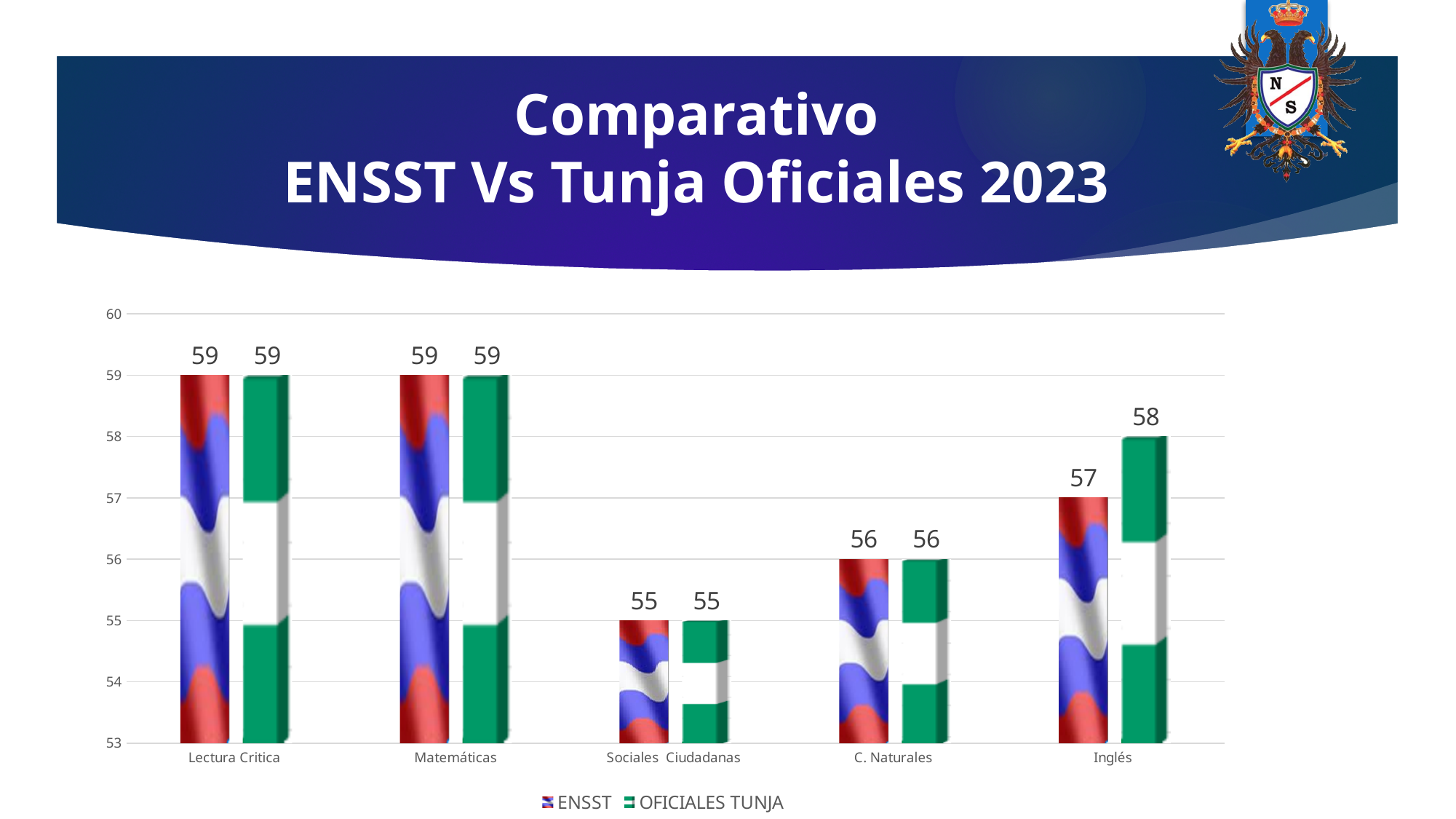
What is the title of the slide? Comparativo ENSST Vs Tunja Oficiales 2023 What is the difference between the OFICIALES TUNJA and ENSST values for Inglés? 1 What is the ENSST value for Matemáticas? 59 Which category has the lowest ENSST value? Sociales Ciudadanas What is the ENSST value for Sociales Ciudadanas? 55 How many series does the legend list? 2 For Inglés, which is larger: the ENSST value or the OFICIALES TUNJA value? OFICIALES TUNJA What is the OFICIALES TUNJA value for C. Naturales? 56 What kind of chart is shown on the slide? bar chart Is the ENSST value for C. Naturales greater or less than 55? greater What is the OFICIALES TUNJA value for Inglés? 58 How many categories are shown on the x axis? 5